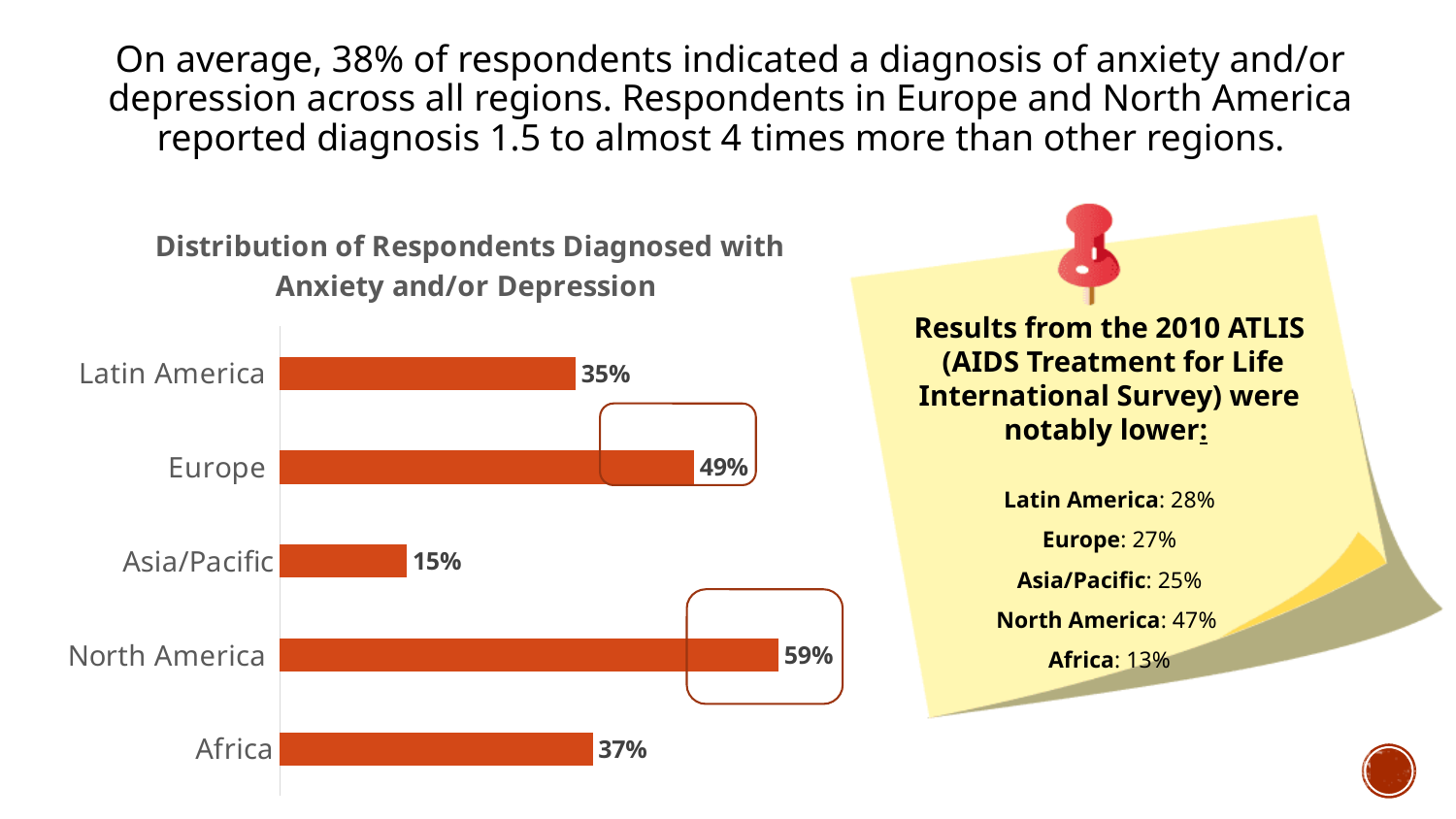
What is the value shown for Asia/Pacific in the chart? 15% What type of chart is used to show the distribution of respondents diagnosed with anxiety and/or depression? Bar chart Which region has the lowest percentage of respondents diagnosed with anxiety and/or depression? Asia/Pacific What is the difference in percentage points between North America and Europe? 10 percentage points Which has a higher value, Europe or Africa? Europe How many regions are shown in the chart? 5 What percentage of respondents in Europe were diagnosed with anxiety and/or depression? 49% Which region has the highest percentage of respondents diagnosed with anxiety and/or depression? North America Which has a higher value, Latin America or Africa? Africa What is the title of the chart? Distribution of Respondents Diagnosed with Anxiety and/or Depression What is the value shown for Africa in the chart? 37% What is the difference in percentage points between Latin America and Asia/Pacific? 20 percentage points